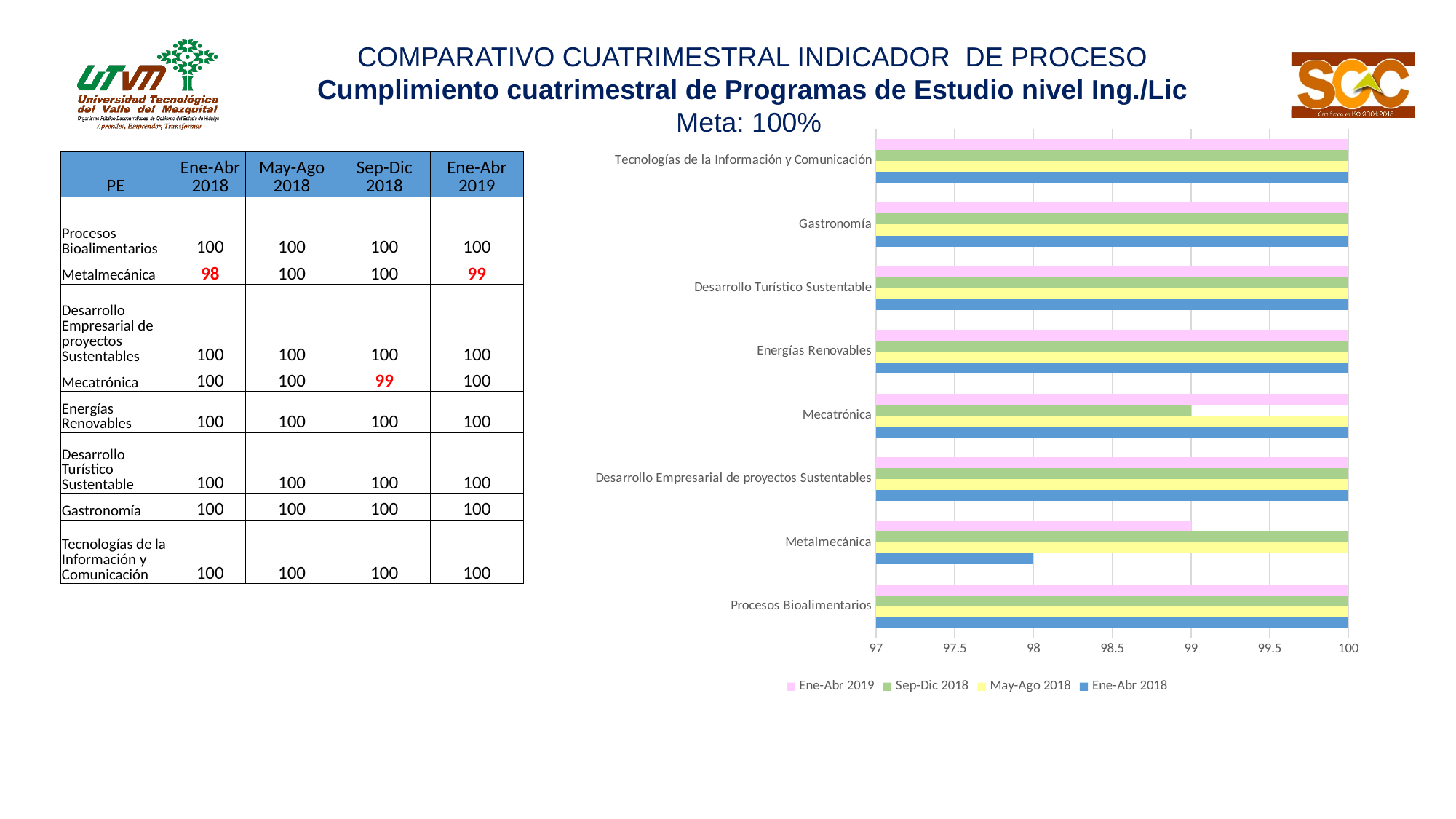
What is the value for Metalmecánica in the Ene-Abr 2018 series? 98 Which program has the lowest value in the Ene-Abr 2018 series? Metalmecánica What is the value for Mecatrónica in the Sep-Dic 2018 series? 99 Which program has the lowest value in the Sep-Dic 2018 series? Mecatrónica What is the value for Gastronomía in the May-Ago 2018 series? 100 What kind of chart is shown on the slide? bar chart Is the value for Metalmecánica in the Ene-Abr 2018 series greater or less than 99? less What is the difference between the Ene-Abr 2019 and Ene-Abr 2018 values for Metalmecánica? 1 Which is larger for Mecatrónica: the Sep-Dic 2018 value or the May-Ago 2018 value? May-Ago 2018 How many programs (categories) are plotted on the chart? 8 What is the value for Metalmecánica in the Ene-Abr 2019 series? 99 How many series does the chart legend list? 4